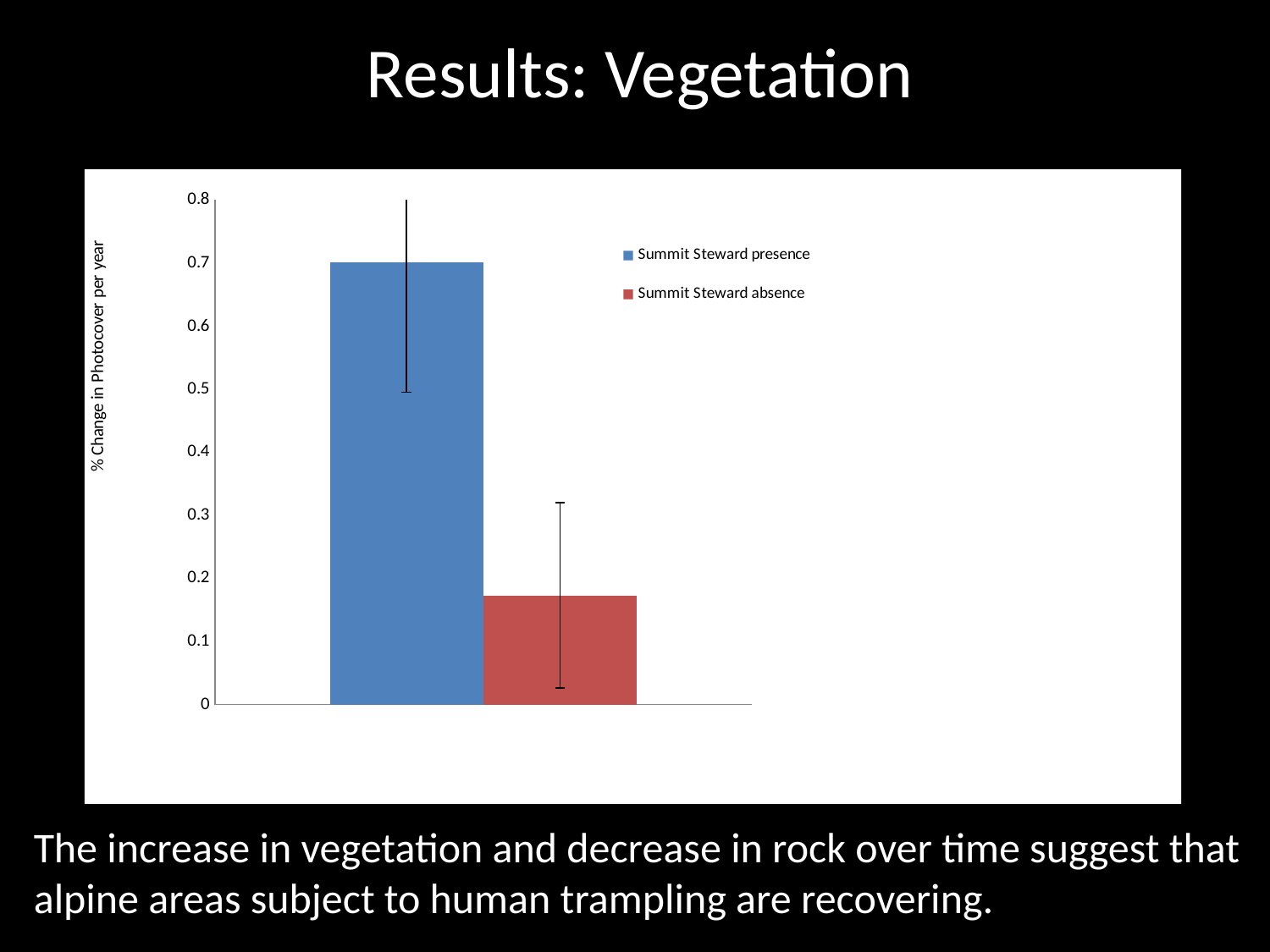
Which series has the higher value, Summit Steward presence or Summit Steward absence? Summit Steward presence Is the value for Summit Steward absence greater or less than 0.2? less How many bars are plotted in the chart? 2 How many series does the legend list? 2 What colour is the bar for Summit Steward absence? red Is the value for Summit Steward presence greater or less than 0.5? greater What kind of chart is shown on the slide? bar chart What is the label on the vertical axis of the chart? % Change in Photocover per year Is the value for Summit Steward absence greater or less than 0.1? greater Which series has the highest bar? Summit Steward presence Which series has the lowest bar? Summit Steward absence